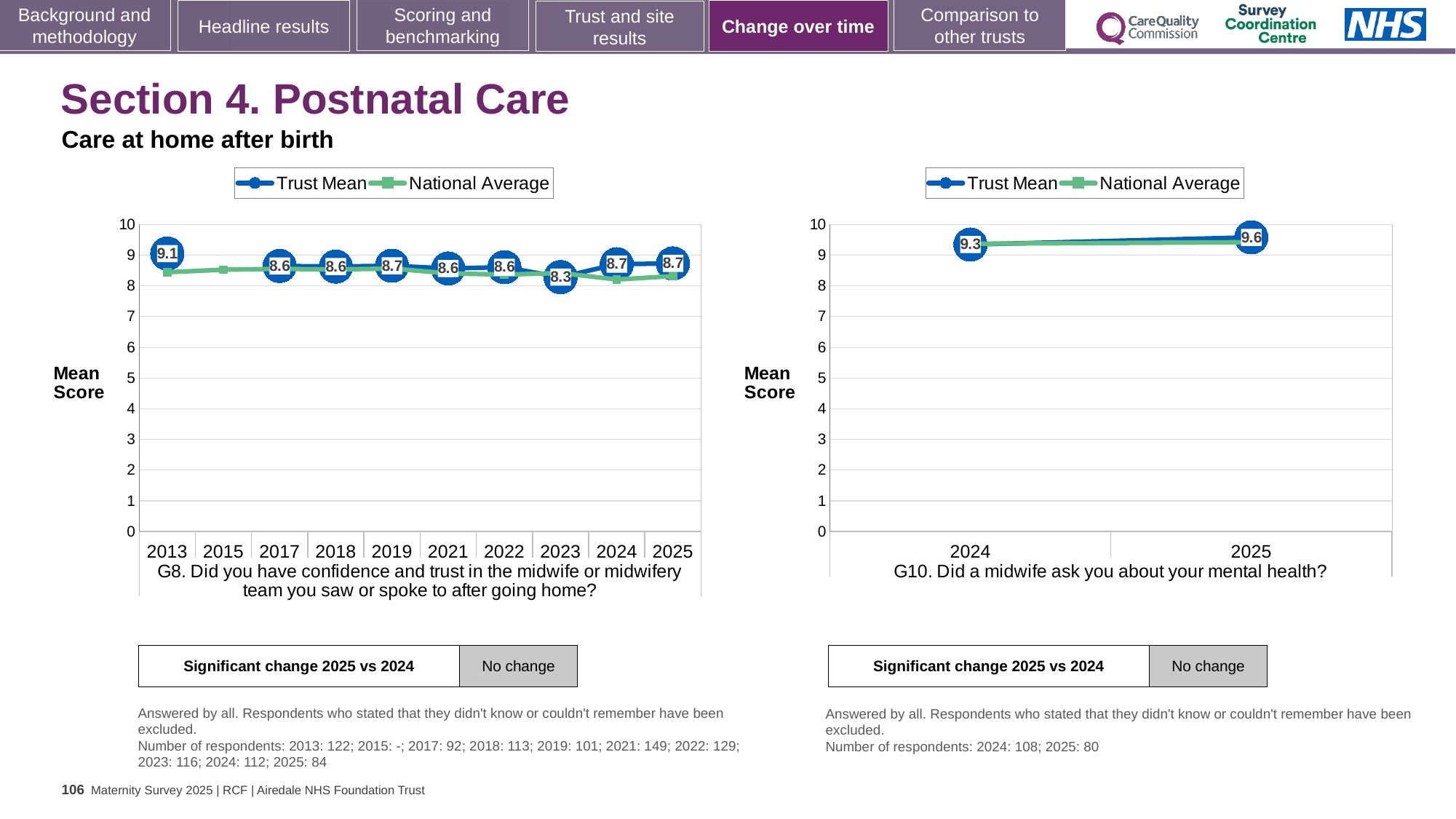
In the right chart (G10), does the Trust Mean rise or fall from 2024 to 2025? rise In the left chart (G8), what is the Trust Mean score for 2013? 9.1 How many series does the legend of the right chart (G10) list? 2 In the left chart (G8), which year has the highest Trust Mean score? 2013 In the left chart (G8), what is the Trust Mean score for 2023? 8.3 In the left chart (G8), what is the difference between the Trust Mean scores for 2013 and 2023? 0.8 In the left chart (G8), is the National Average value for 2013 greater or less than 8? greater In the left chart (G8), which year has the lowest Trust Mean score? 2023 In the right chart (G10), what is the difference between the Trust Mean scores for 2025 and 2024? 0.3 In the left chart (G8), how many years are shown on the x axis? 10 What kind of chart is the left chart (G8)? line chart In the right chart (G10), what is the Trust Mean score for 2025? 9.6